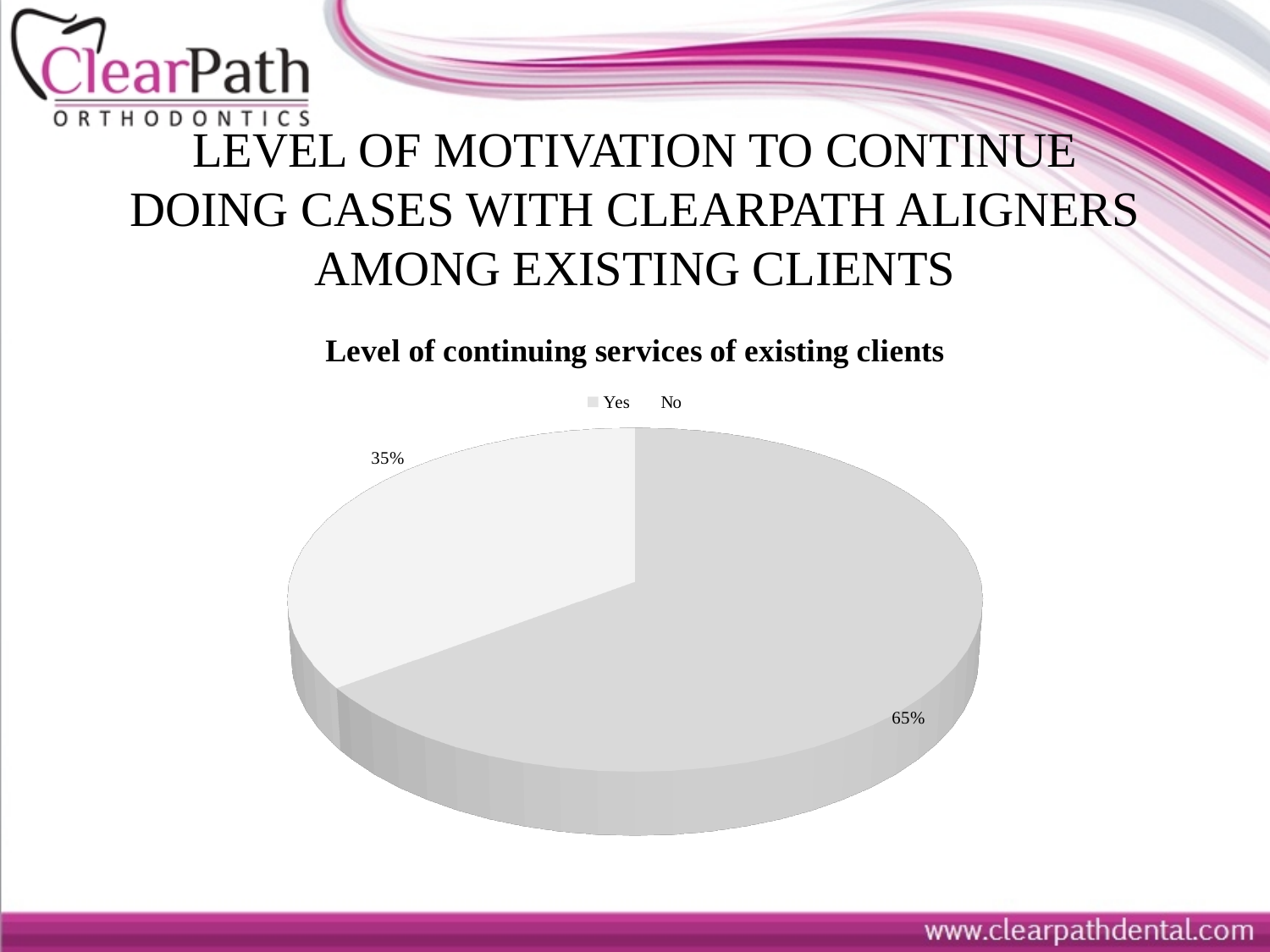
What kind of chart is shown on the slide? Pie chart What percentage is shown for the 'No' slice? 35% Which is larger, the 'Yes' slice or the 'No' slice? Yes Which slice is the smallest in the pie chart? No What percentage is shown for the 'Yes' slice? 65% What share of the pie does the 'No' slice represent? 35% How many slices does the pie chart have? 2 How many series does the chart legend list? 2 What is the title of the chart? Level of continuing services of existing clients Which slice is the largest in the pie chart? Yes What is the difference in percentage points between the 'Yes' and 'No' slices? 30 What are the entries in the chart legend? Yes, No